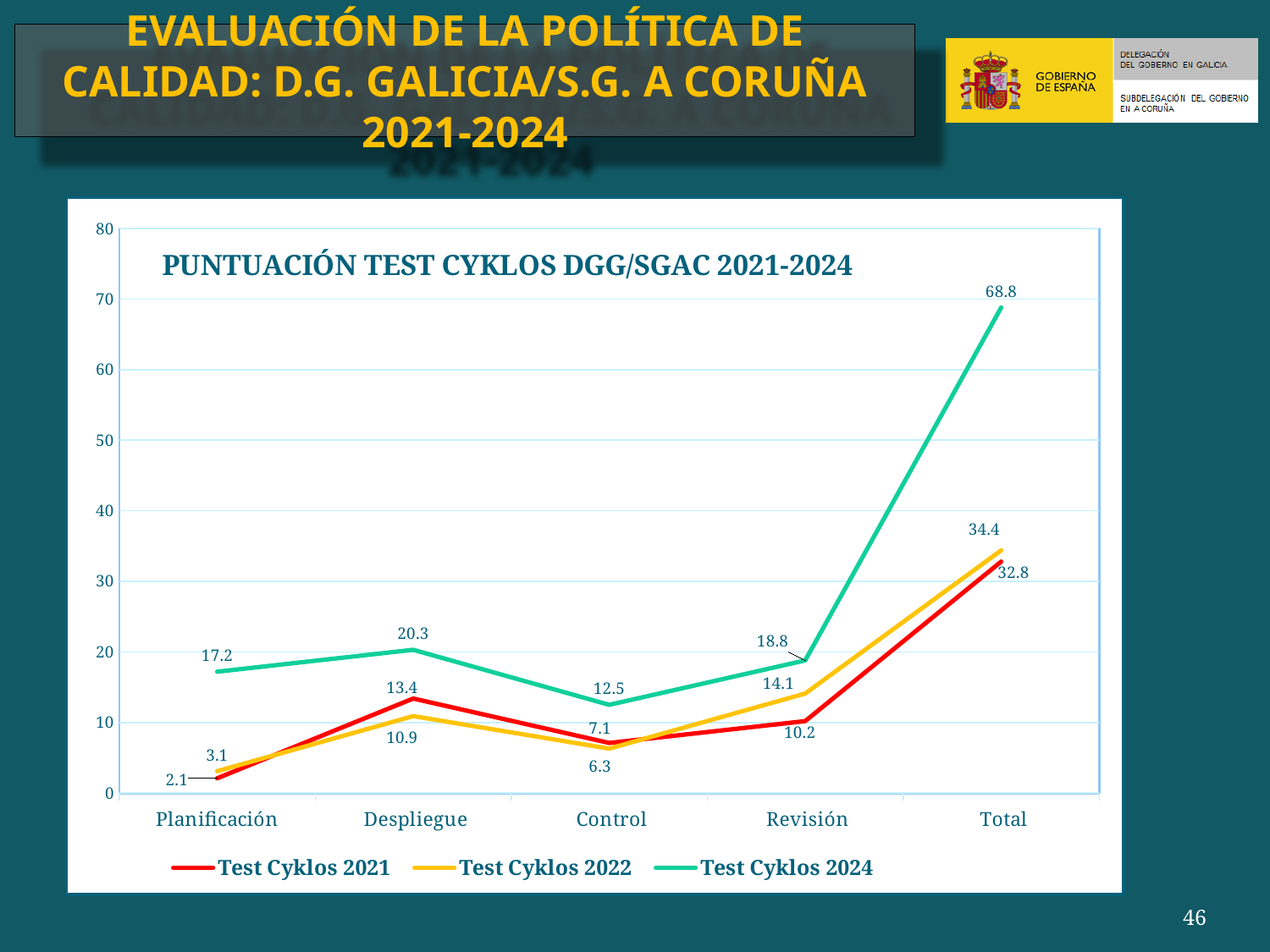
What is the value of Test Cyklos 2024 for Total? 68.8 Which category has the highest value for Test Cyklos 2024? Total What kind of chart is shown on the slide? line chart Is the Total value for Test Cyklos 2024 greater or less than 60? greater What is the value of Test Cyklos 2021 for Despliegue? 13.4 What is the difference between the Total values of Test Cyklos 2024 and Test Cyklos 2022? 34.4 How many series does the legend list? 3 How many categories are shown on the x axis? 5 What is the title of the chart? PUNTUACIÓN TEST CYKLOS DGG/SGAC 2021-2024 Which category has the lowest value for Test Cyklos 2021? Planificación What is the value of Test Cyklos 2022 for Revisión? 14.1 For Despliegue, which series has the larger value, Test Cyklos 2021 or Test Cyklos 2022? Test Cyklos 2021